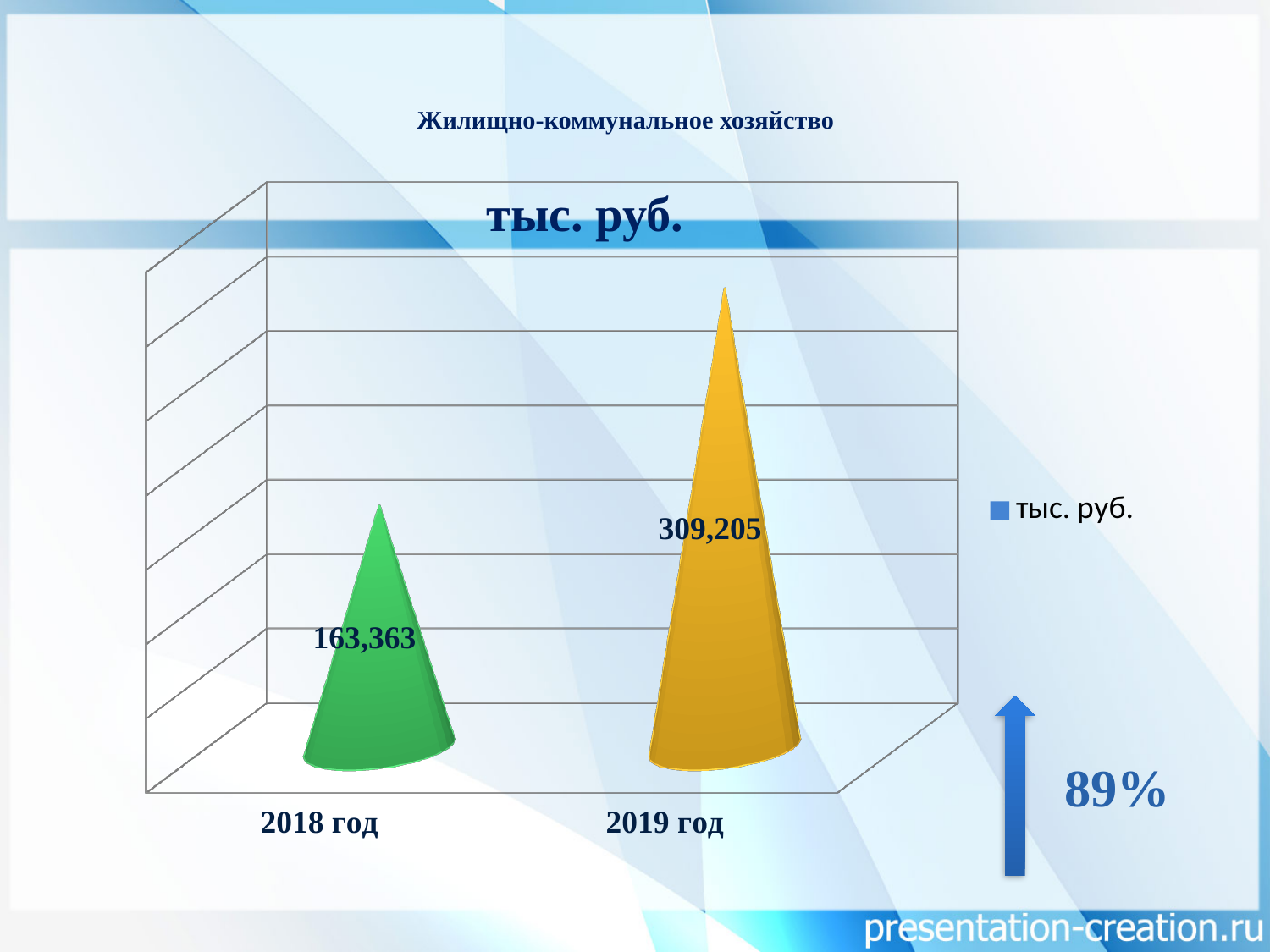
What is the difference between the values for 2019 год and 2018 год? 145,842 What kind of chart is shown? bar chart What colour is the bar for 2019 год? orange How many series does the legend list? 1 What is the value for 2019 год? 309,205 What is the title of the chart? тыс. руб. Do the values rise or fall from 2018 год to 2019 год? rise How many categories are shown on the x axis? 2 Is the value for 2019 год larger or smaller than the value for 2018 год? larger Which year has the lower value? 2018 год Which year has the higher value? 2019 год What is the value for 2018 год? 163,363